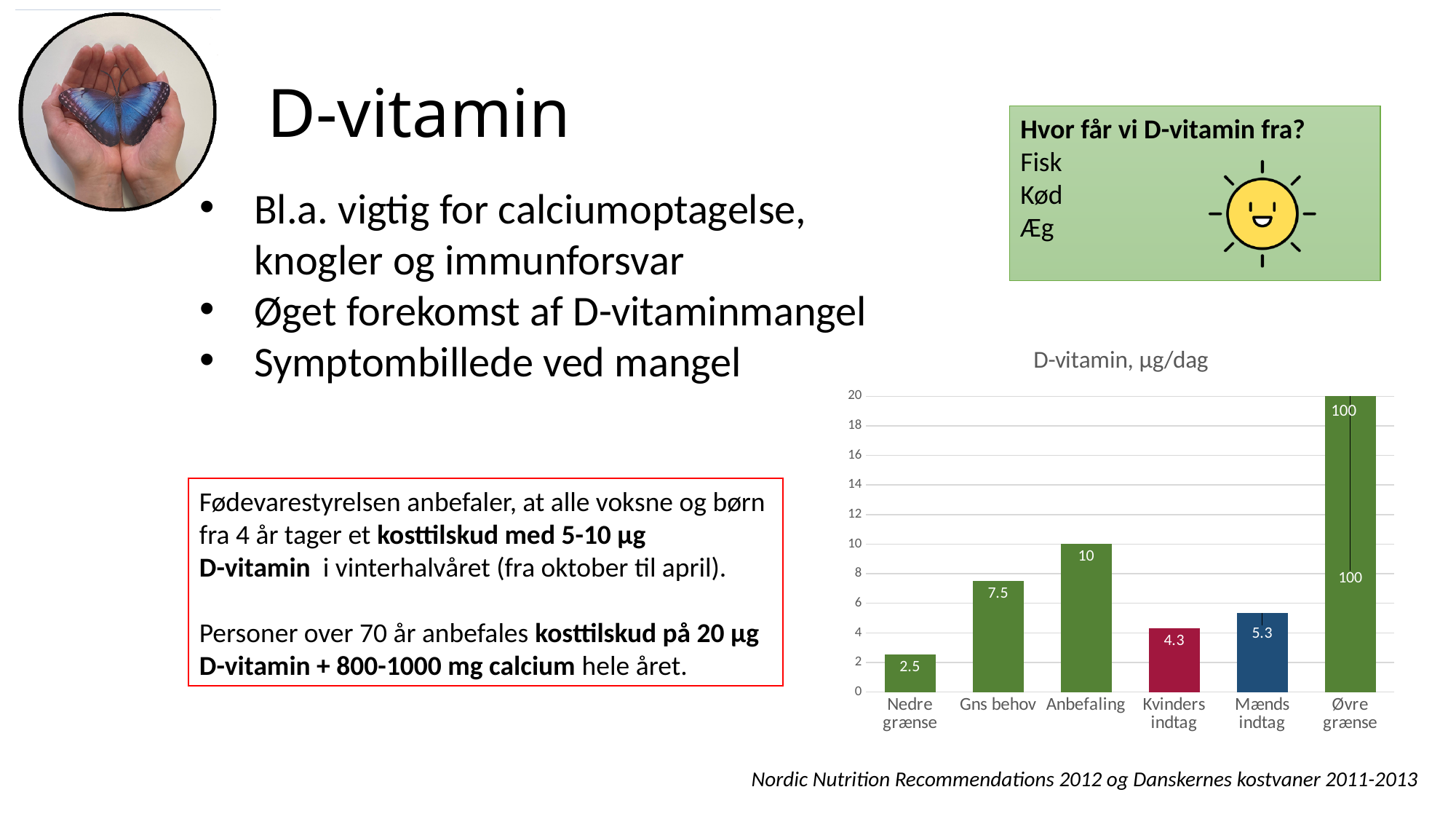
What kind of chart is the D-vitamin, µg/dag chart? Bar chart What is the value labelled on the Øvre grænse bar in the D-vitamin, µg/dag chart? 100 How many categories are shown in the D-vitamin, µg/dag chart? 6 What is the value for Gns behov in the D-vitamin, µg/dag chart? 7.5 What is the value for Nedre grænse in the D-vitamin, µg/dag chart? 2.5 Which category has the lowest value in the D-vitamin, µg/dag chart? Nedre grænse Which category has the highest value in the D-vitamin, µg/dag chart? Øvre grænse What is the value for Kvinders indtag in the D-vitamin, µg/dag chart? 4.3 What is the difference between Mænds indtag and Kvinders indtag in the D-vitamin, µg/dag chart? 1 What is the difference between Anbefaling and Gns behov in the D-vitamin, µg/dag chart? 2.5 Which is larger in the D-vitamin, µg/dag chart: Kvinders indtag or Mænds indtag? Mænds indtag What is the value for Anbefaling in the D-vitamin, µg/dag chart? 10